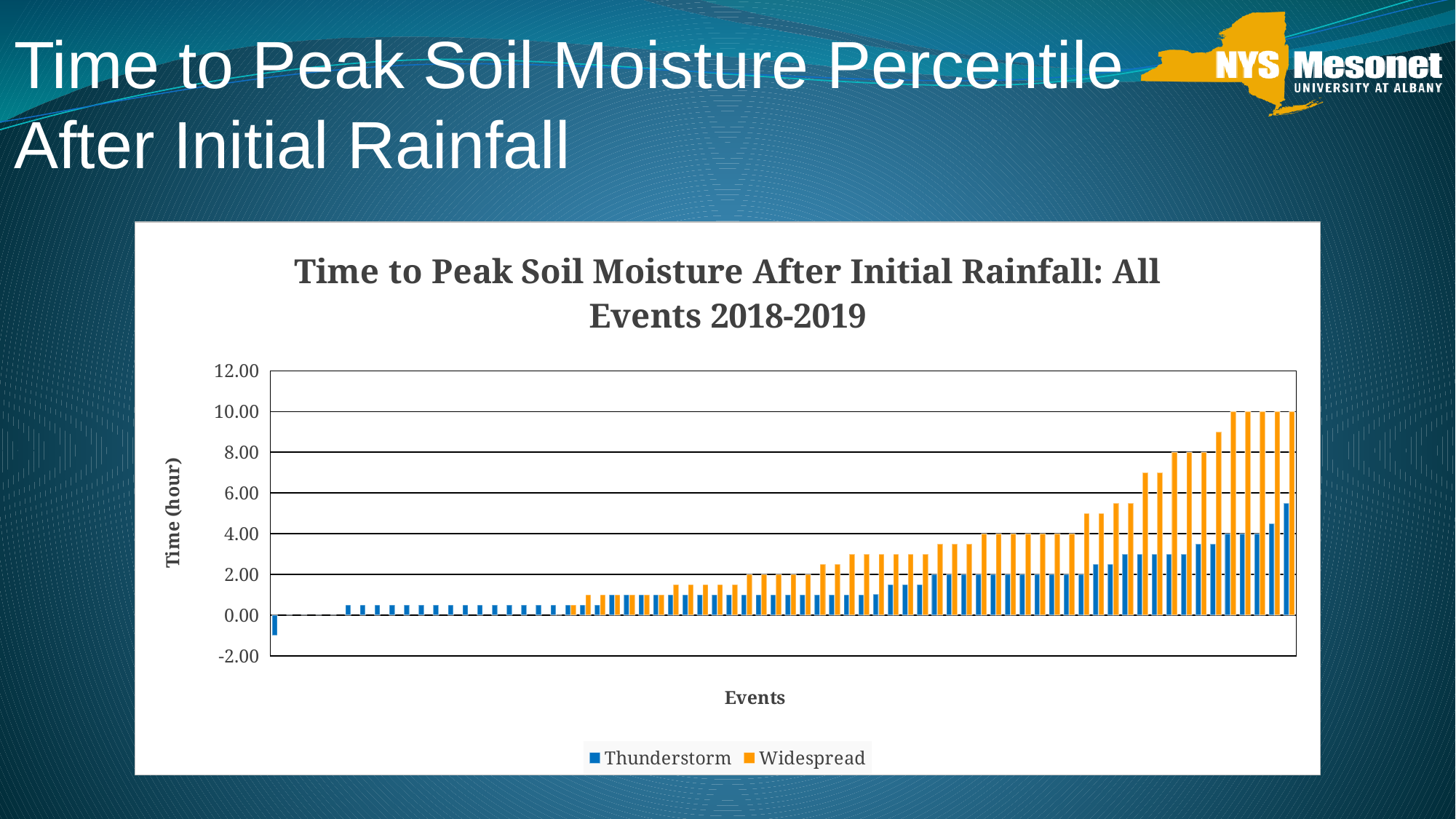
What are the two series named in the legend? Thunderstorm and Widespread Is the tallest Widespread bar greater or less than 8.00 hours? greater What kind of chart is shown on the slide? Bar chart How many series does the legend list? 2 Do the bar values generally rise or fall from left to right along the x axis? Rise Is the tallest Widespread bar greater or less than 12.00 hours? less What is the title of the chart? Time to Peak Soil Moisture After Initial Rainfall: All Events 2018-2019 Is the tallest Thunderstorm bar greater or less than 6.00 hours? less Which series has the tallest bars on the chart, Thunderstorm or Widespread? Widespread What is the highest value shown on the y axis? 12.00